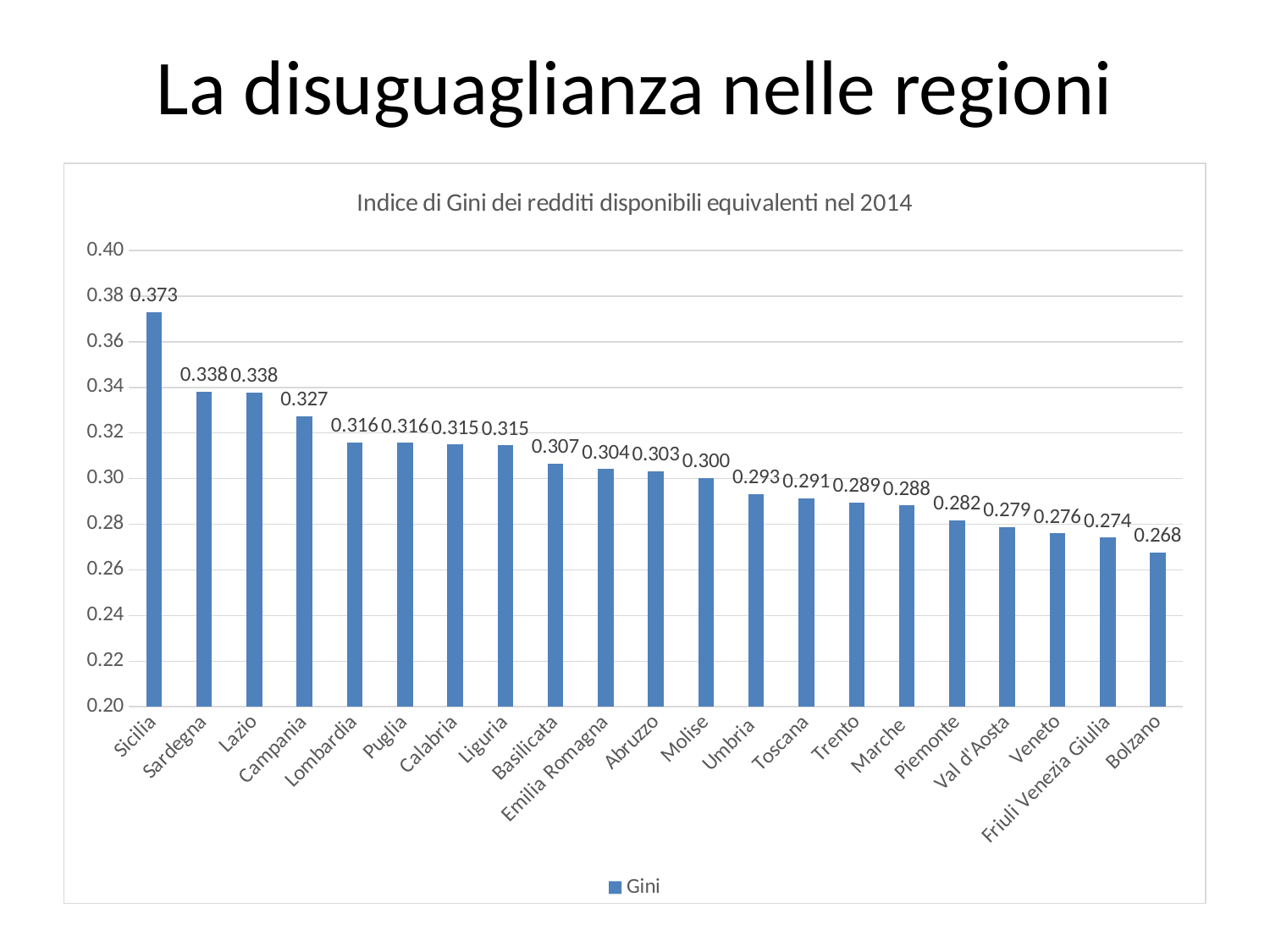
Which region has the lowest Gini index? Bolzano Do the Gini index values rise or fall from left to right across the regions? fall What is the Gini index value for Sicilia? 0.373 What kind of chart is shown on the slide? bar chart What is the Gini index value for Toscana? 0.291 What is the difference between the Gini index of Campania and that of Molise? 0.027 Which has a higher Gini index, Umbria or Piemonte? Umbria Which region has the highest Gini index? Sicilia How many regions are shown in the chart? 21 What is the difference between the Gini index of Sicilia and that of Bolzano? 0.105 What is the Gini index value for Campania? 0.327 Is the Gini index for Veneto greater or less than 0.30? less